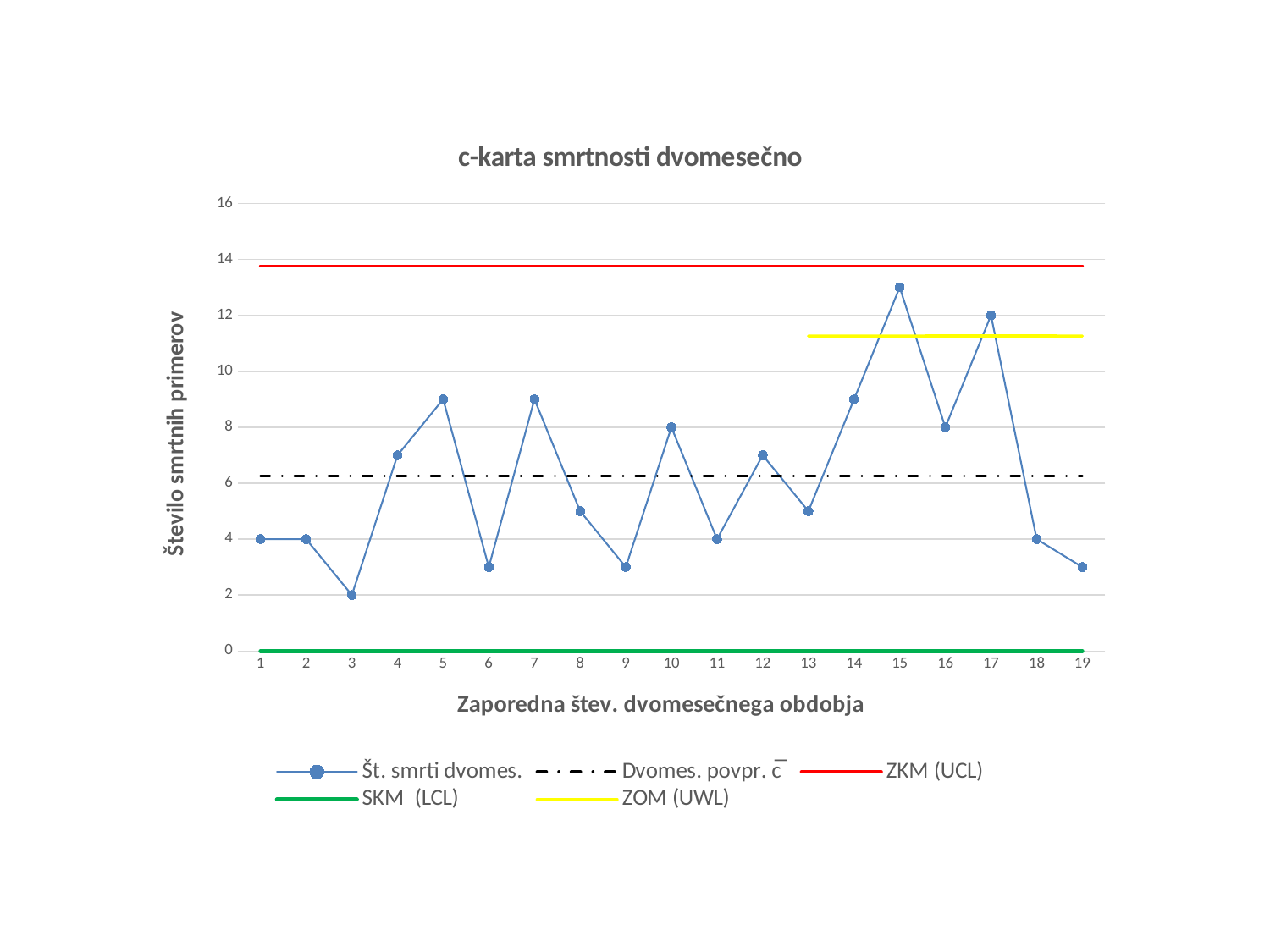
How many periods are plotted along the x axis? 19 Which period has the lowest number of deaths (Št. smrti dvomes.)? 3 Which has the larger value, period 5 or period 6? period 5 How many series does the legend list? 5 Is the value for period 15 greater or less than 12? greater What type of chart is shown on the slide? line chart What is the title of the chart? c-karta smrtnosti dvomesečno What is the difference between the values for period 17 and period 3? 10 What is the value of Št. smrti dvomes. for period 17? 12 Which period has the highest number of deaths (Št. smrti dvomes.)? 15 What is the value of Št. smrti dvomes. for period 3? 2 What is the value of Št. smrti dvomes. for period 10? 8